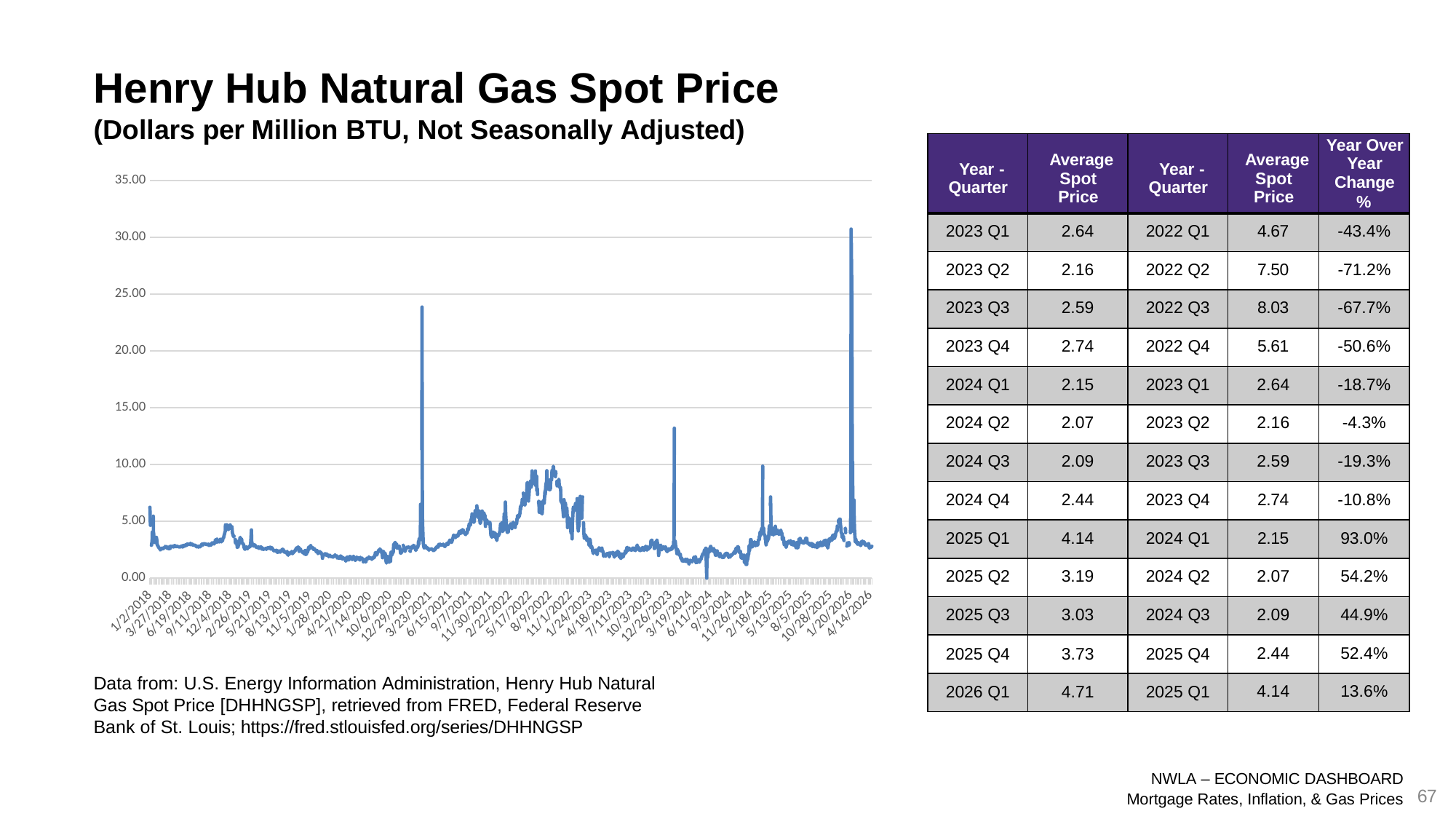
Is the value of the line around 8/13/2019 greater or less than 5? less Is the value of the spike near 12/26/2023 greater or less than 10? greater What kind of chart is shown on the slide? line chart Between 2/22/2022 and 8/9/2022, does the line generally rise or fall? rise Is the value of the spike near 3/23/2021 greater or less than 20? greater What is the highest value shown on the chart's y axis? 35.00 Near which x-axis date does the line reach its highest spike? 1/20/2026 What is the title of the chart on the slide? Henry Hub Natural Gas Spot Price How many lines are plotted on the chart? 1 What units does the chart's subtitle say the prices are in? Dollars per Million BTU, Not Seasonally Adjusted